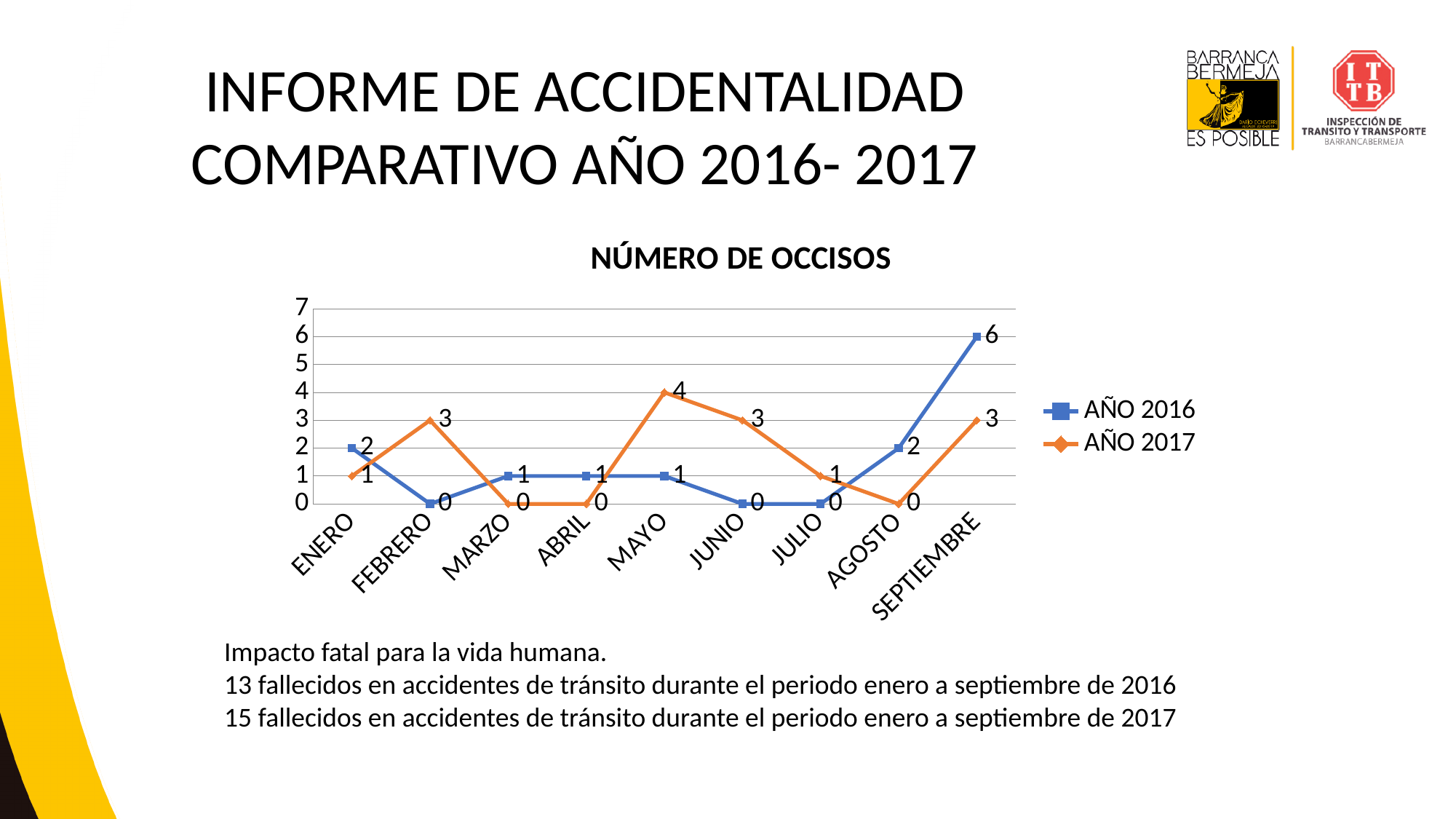
Which series has the larger value in JUNIO, AÑO 2016 or AÑO 2017? AÑO 2017 In which month does AÑO 2017 reach its highest value? MAYO What is the value for AÑO 2017 in FEBRERO? 3 What type of chart is shown on the slide? line chart In which month does AÑO 2016 reach its highest value? SEPTIEMBRE What is the difference between AÑO 2016 and AÑO 2017 in SEPTIEMBRE? 3 What is the title of the chart? NÚMERO DE OCCISOS How many months are shown on the x axis? 9 What is the value for AÑO 2017 in MAYO? 4 What is the value for AÑO 2016 in SEPTIEMBRE? 6 Does the AÑO 2016 line rise or fall from AGOSTO to SEPTIEMBRE? rise How many series does the legend list? 2